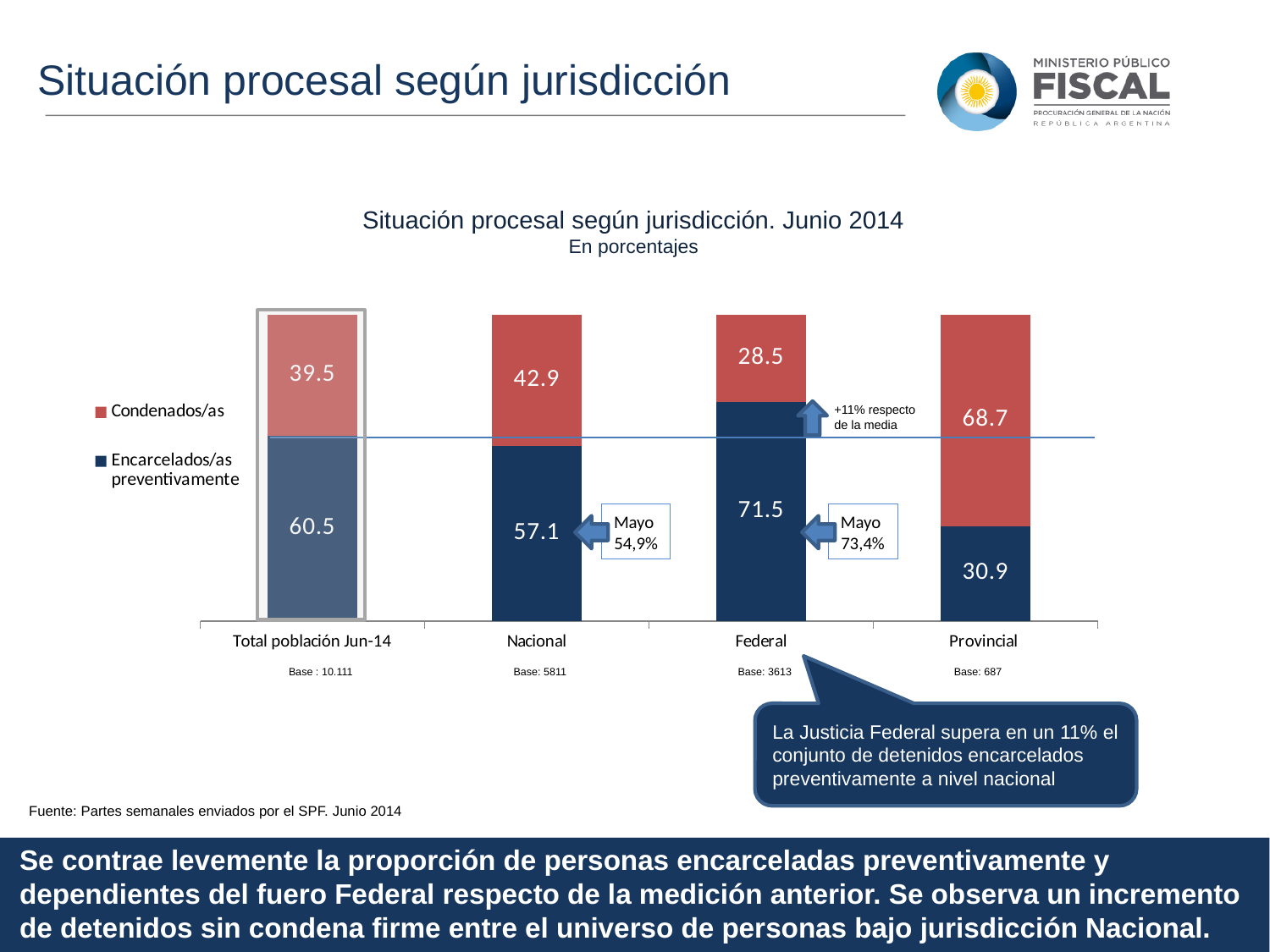
What is the value of Encarcelados/as preventivamente for Total población Jun-14? 60.5 Which category has the highest value for Encarcelados/as preventivamente? Federal What is the difference between the Encarcelados/as preventivamente values for Federal and Nacional? 14.4 What is the value of Encarcelados/as preventivamente for Federal? 71.5 What is the value of Condenados/as for Provincial? 68.7 Which category has the lowest value for Condenados/as? Federal What type of chart is shown on the slide? Stacked bar chart How many series does the chart legend list? 2 What is the title of the chart? Situación procesal según jurisdicción. Junio 2014 What is the value of Condenados/as for Nacional? 42.9 Which is larger: the Condenados/as value for Provincial or for Nacional? Provincial How many categories are shown on the x axis of the chart? 4